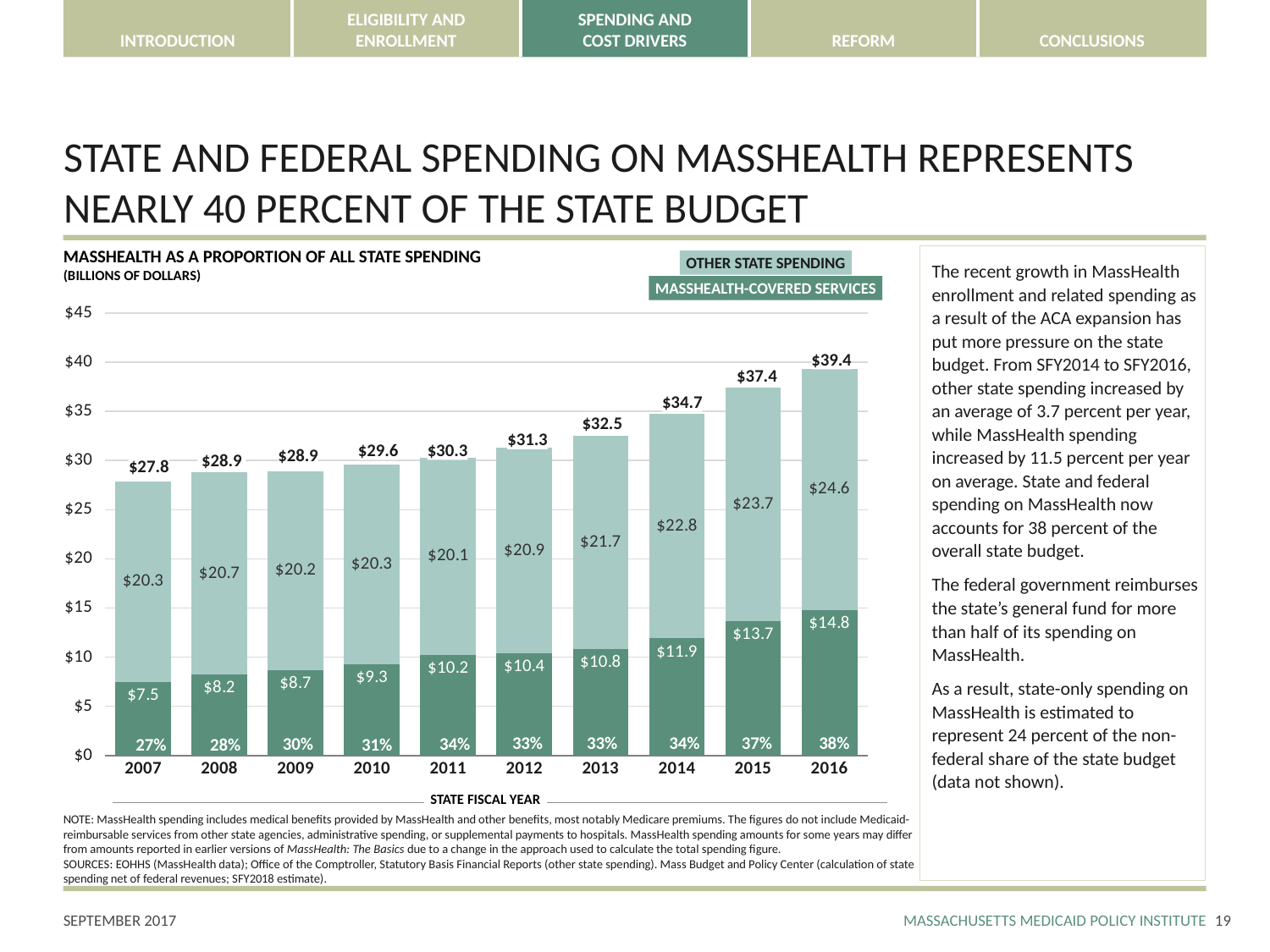
What is the total state spending shown for 2013? $32.5 What is the difference between the total state spending in 2016 and in 2007? $11.6 How many state fiscal years are shown on the x axis? 10 What is the MassHealth-covered services value for 2016? $14.8 Does total state spending rise or fall from 2007 to 2016? Rise What kind of chart is shown on the slide? Stacked bar chart Which year has the lowest MassHealth-covered services value? 2007 How many series does the legend list? 2 What percentage of state spending did MassHealth represent in 2015? 37% Which is larger, the MassHealth-covered services value in 2014 or in 2012? 2014 Which year has the highest total state spending? 2016 What is the other state spending value for 2007? $20.3